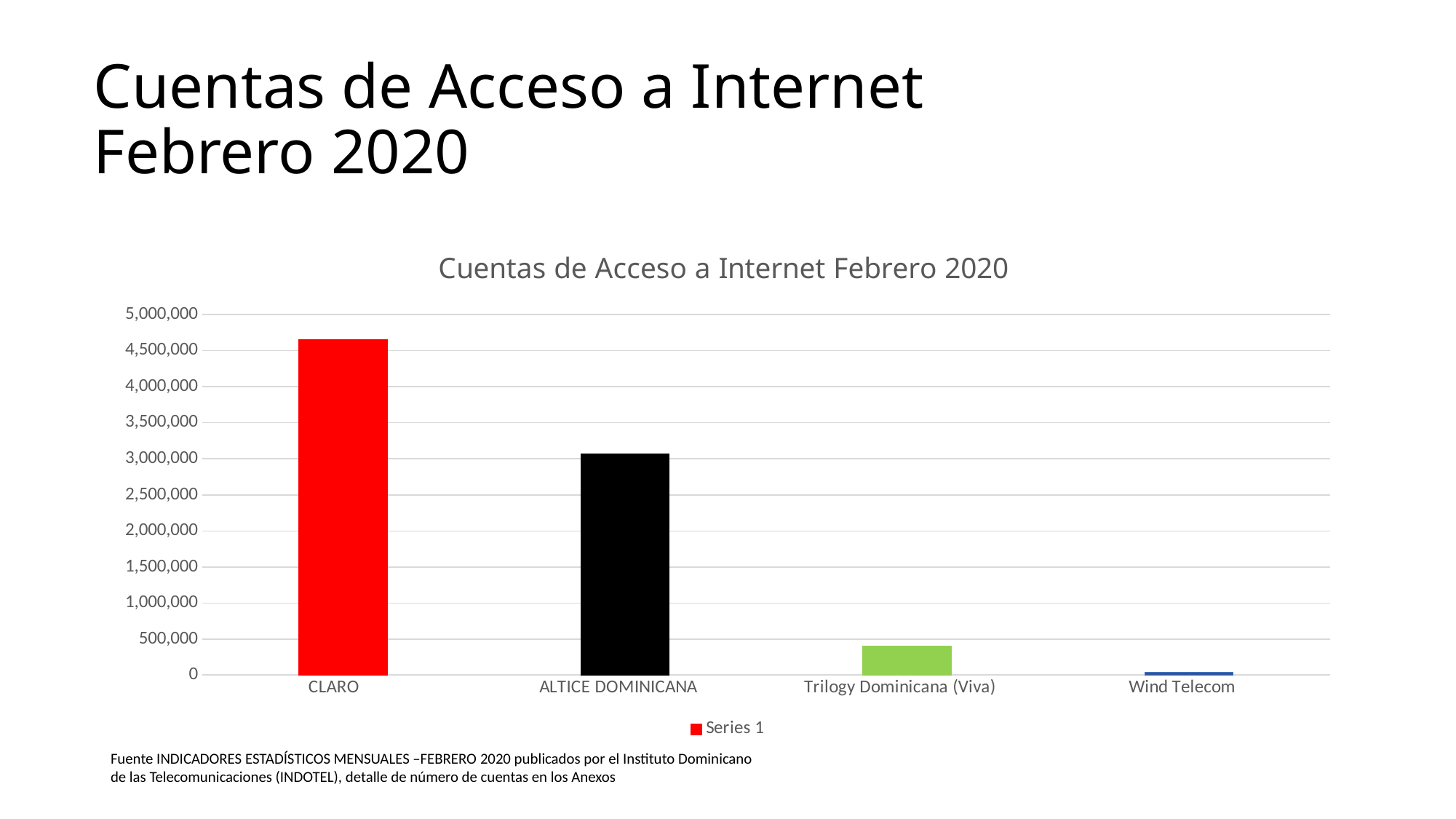
How many series does the legend list? 1 How many categories are shown on the x axis? 4 What is the title of the chart? Cuentas de Acceso a Internet Febrero 2020 Which is larger, the value for ALTICE DOMINICANA or the value for Trilogy Dominicana (Viva)? ALTICE DOMINICANA Which category has the highest value? CLARO Which category has the lowest value? Wind Telecom Is the value for CLARO greater or less than 4,500,000? greater Is the value for Wind Telecom greater or less than 500,000? less What colour is the bar for CLARO? red Is the value for Trilogy Dominicana (Viva) greater or less than 500,000? less What kind of chart is shown on the slide? bar chart